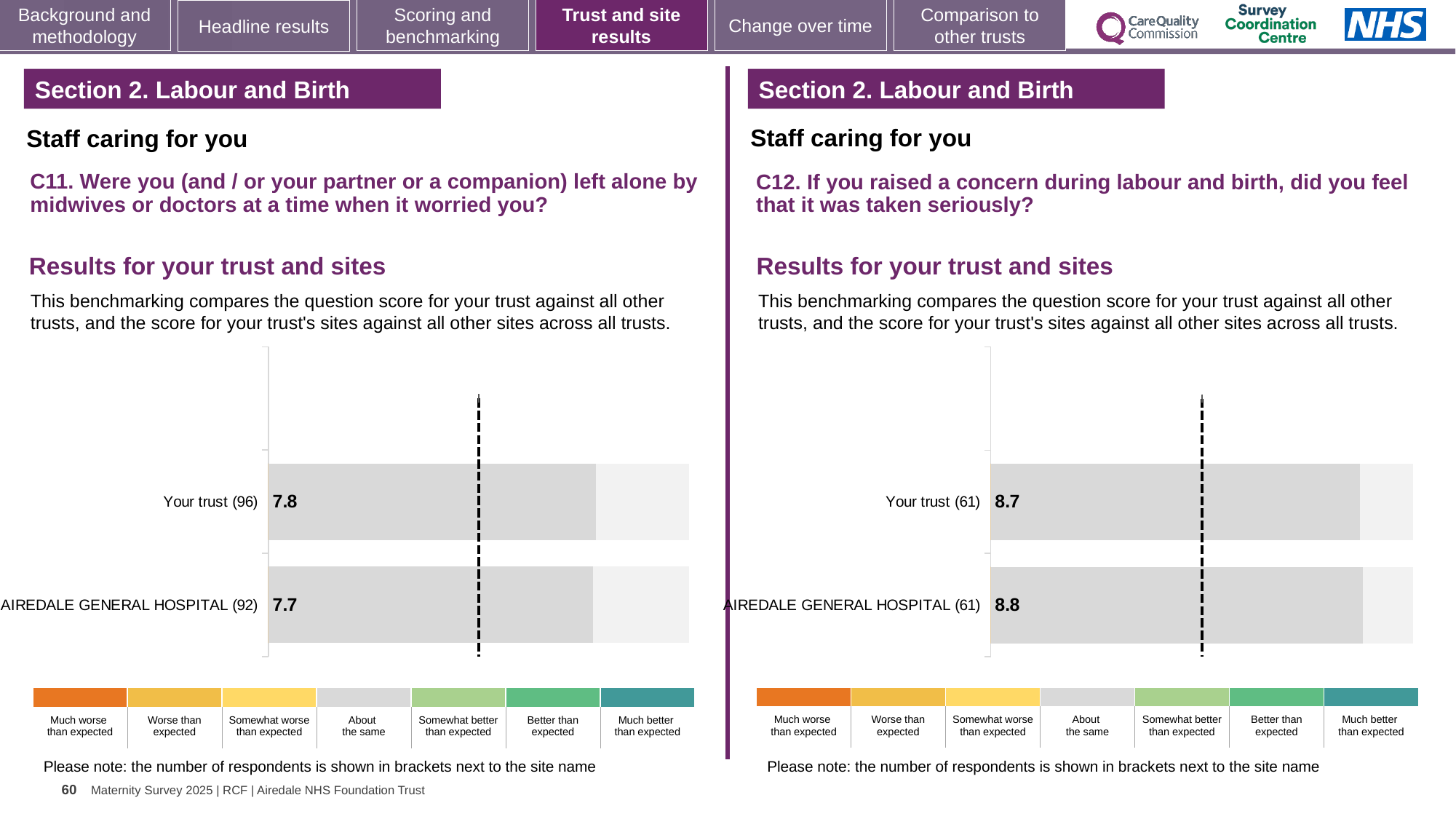
In the C11 chart on the left, what is the score for Your trust? 7.8 In the C12 chart on the right, what is the score for Airedale General Hospital? 8.8 In the C12 chart on the right, what is the score for Your trust? 8.7 What kind of chart is used for the C12 results on the right? Bar chart In the C12 chart on the right, what is the difference between the scores for Airedale General Hospital and Your trust? 0.1 In the C11 chart on the left, which has the higher score, Your trust or Airedale General Hospital? Your trust In the C12 chart on the right, which has the lower score, Your trust or Airedale General Hospital? Your trust In the C11 chart on the left, what is the difference between the scores for Your trust and Airedale General Hospital? 0.1 In the C12 chart on the right, how many respondents are shown in brackets for Your trust? 61 In the C11 chart on the left, what is the score for Airedale General Hospital? 7.7 How many bars are plotted in the C11 chart on the left? 2 In the C11 chart on the left, how many respondents are shown in brackets for Airedale General Hospital? 92